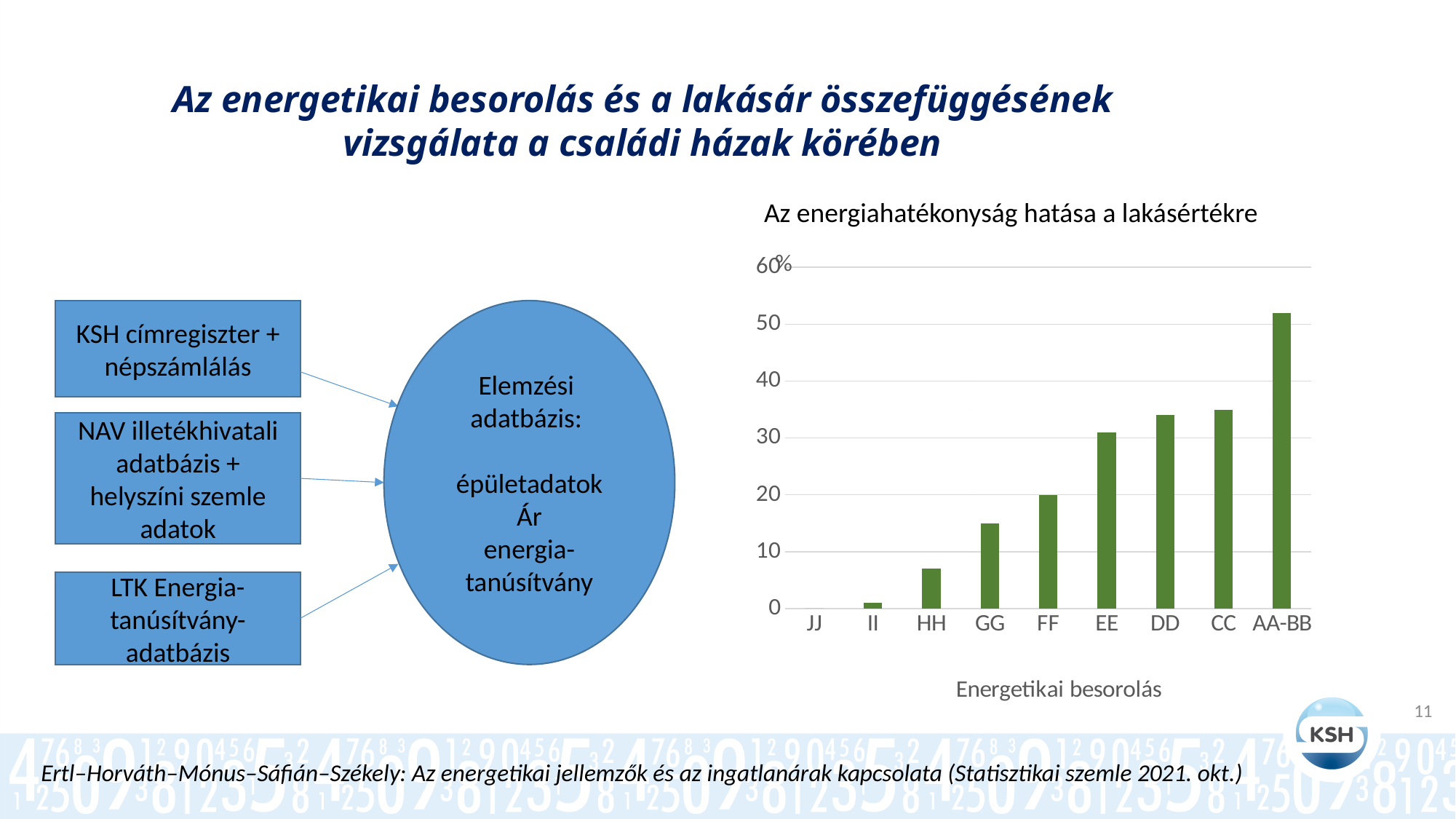
Is the value for EE greater or less than 20? greater Do the values rise or fall moving from JJ to AA-BB along the x axis? rise How many energy rating categories are shown on the x axis of the chart? 9 Which energy rating category has the lowest value in the chart? JJ Is the value for GG greater or less than 20? less Which has the larger value, HH or FF? FF What kind of chart is shown on the slide? bar chart Which has the larger value, CC or GG? CC Is the value for HH greater or less than 10? less What is the title of the chart? Az energiahatékonyság hatása a lakásértékre Which energy rating category has the highest bar in the chart? AA-BB